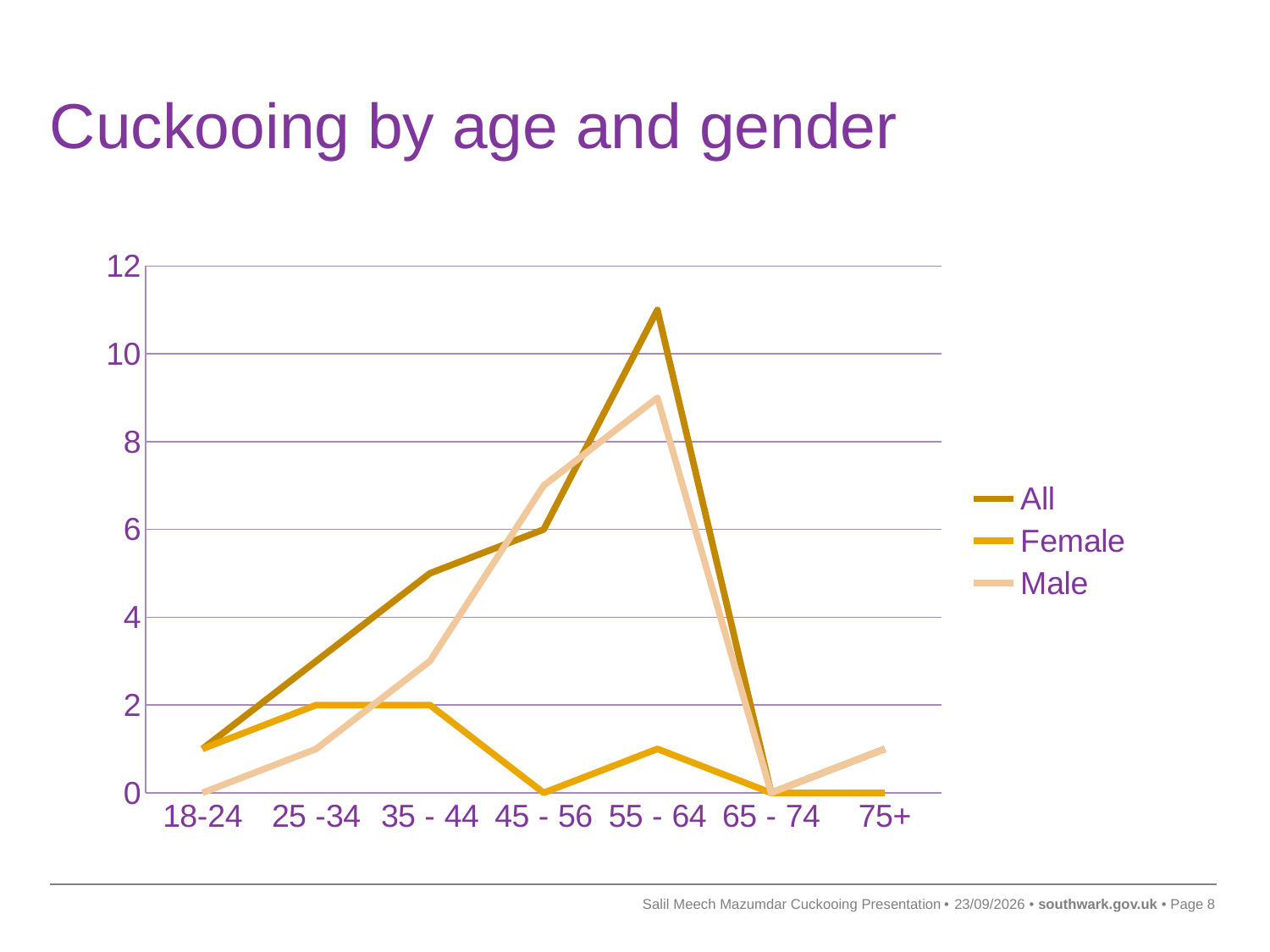
What kind of chart is shown on the slide? line chart How many age categories are shown on the x axis? 7 What is the value of the All series for the 45 - 56 age group? 6 Is the value of the Male series for the 55 - 64 age group greater or less than 8? greater What is the value of the Male series for the 18-24 age group? 0 How many series does the legend list? 3 For the 45 - 56 age group, which series has the larger value, Male or Female? Male Is the value of the All series for the 55 - 64 age group greater or less than 10? greater Which age group has the highest value for the All series? 55 - 64 What is the title of the chart? Cuckooing by age and gender What is the value of the Female series for the 45 - 56 age group? 0 What is the value of the Female series for the 35 - 44 age group? 2